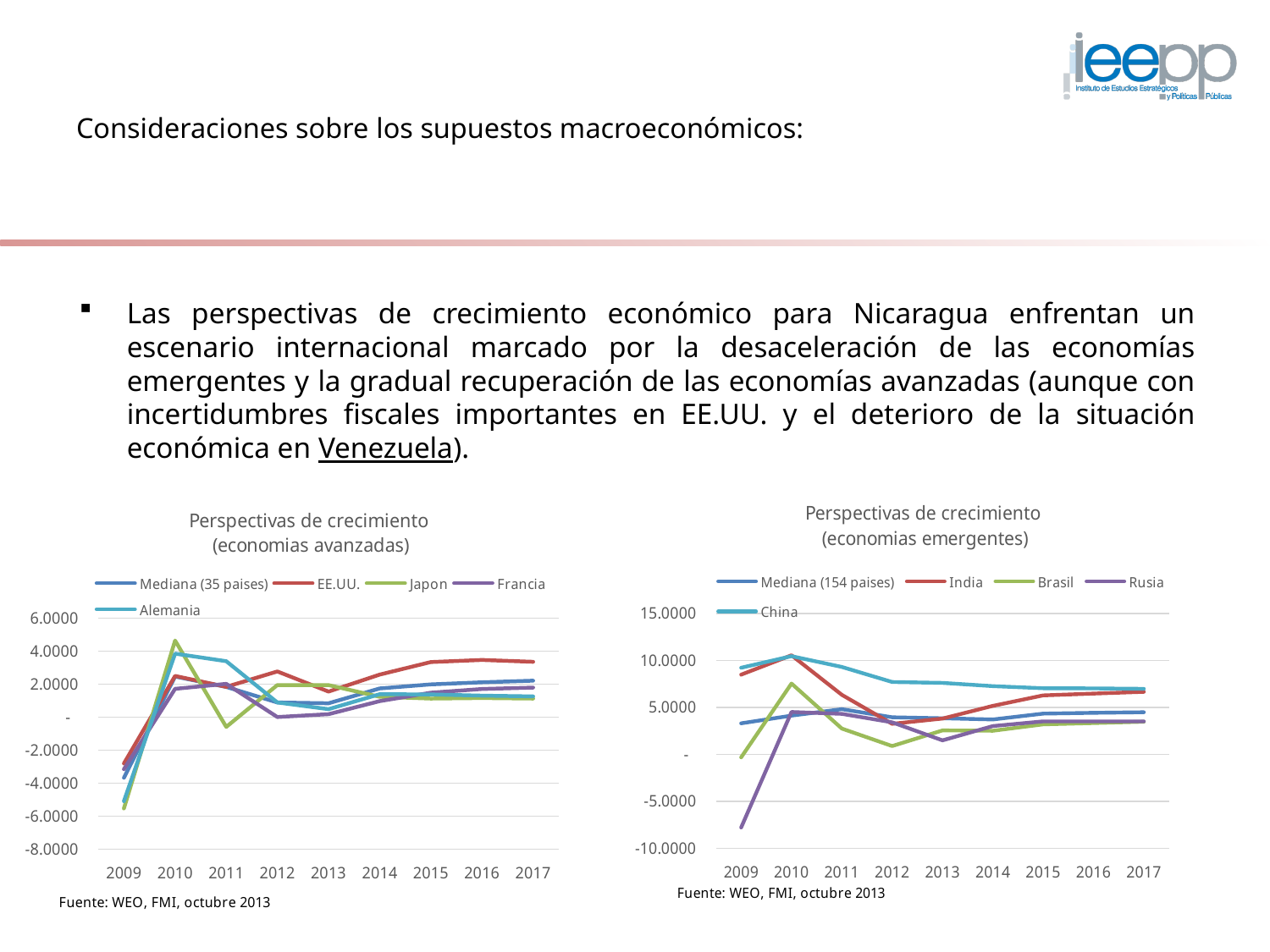
In the 'Perspectivas de crecimiento (economias avanzadas)' chart, which is larger in 2009, the value for EE.UU. or the value for Japon? EE.UU. In the 'Perspectivas de crecimiento (economias emergentes)' chart, is the value for Rusia in 2009 greater or less than -5.0000? less How many series does the legend of the 'Perspectivas de crecimiento (economias emergentes)' chart list? 5 In the 'Perspectivas de crecimiento (economias emergentes)' chart, is the value for China in 2017 greater or less than 5.0000? greater In the 'Perspectivas de crecimiento (economias emergentes)' chart, which series has the lowest value in 2009? Rusia What source is cited below the 'Perspectivas de crecimiento (economias emergentes)' chart? Fuente: WEO, FMI, octubre 2013 In the 'Perspectivas de crecimiento (economias avanzadas)' chart, is the value for Japon in 2009 greater or less than -4.0000? less How many years are shown on the x axis of the 'Perspectivas de crecimiento (economias avanzadas)' chart? 9 What kind of chart is the 'Perspectivas de crecimiento (economias avanzadas)' chart? line chart In the 'Perspectivas de crecimiento (economias avanzadas)' chart, which series has the highest value in 2010? Japon In the 'Perspectivas de crecimiento (economias emergentes)' chart, does the value for China rise or fall from 2010 to 2017? fall In the 'Perspectivas de crecimiento (economias emergentes)' chart, which series has the lowest value in 2012? Brasil